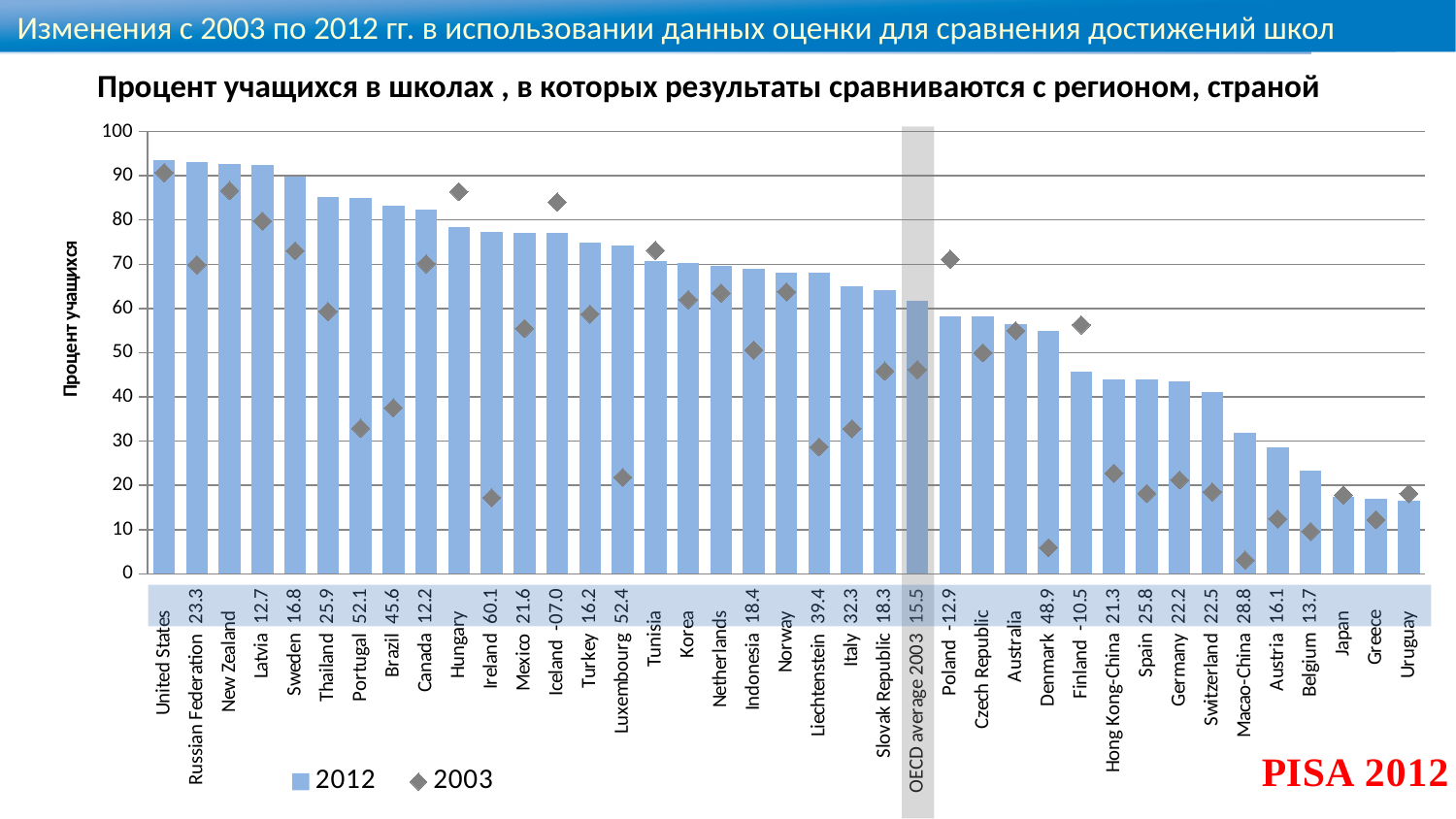
Is the 2003 value for Denmark greater or less than 10? less Which two series are listed in the legend? 2012 and 2003 Is the 2012 value for United States greater or less than 90? greater Is the 2003 value for Ireland greater or less than 20? less How many series does the legend list? 2 For Hungary, which is larger: the 2012 value or the 2003 value? 2003 What kind of chart is shown on the slide? Combination chart: bars for 2012 with diamond markers for 2003 For Ireland, which is larger: the 2012 value or the 2003 value? 2012 What number is printed next to Russian Federation on the category axis? 23.3 Which category has the highest 2012 bar? United States Do the 2012 bars rise or fall from left to right along the x axis? fall How many categories are shown along the x axis? 39